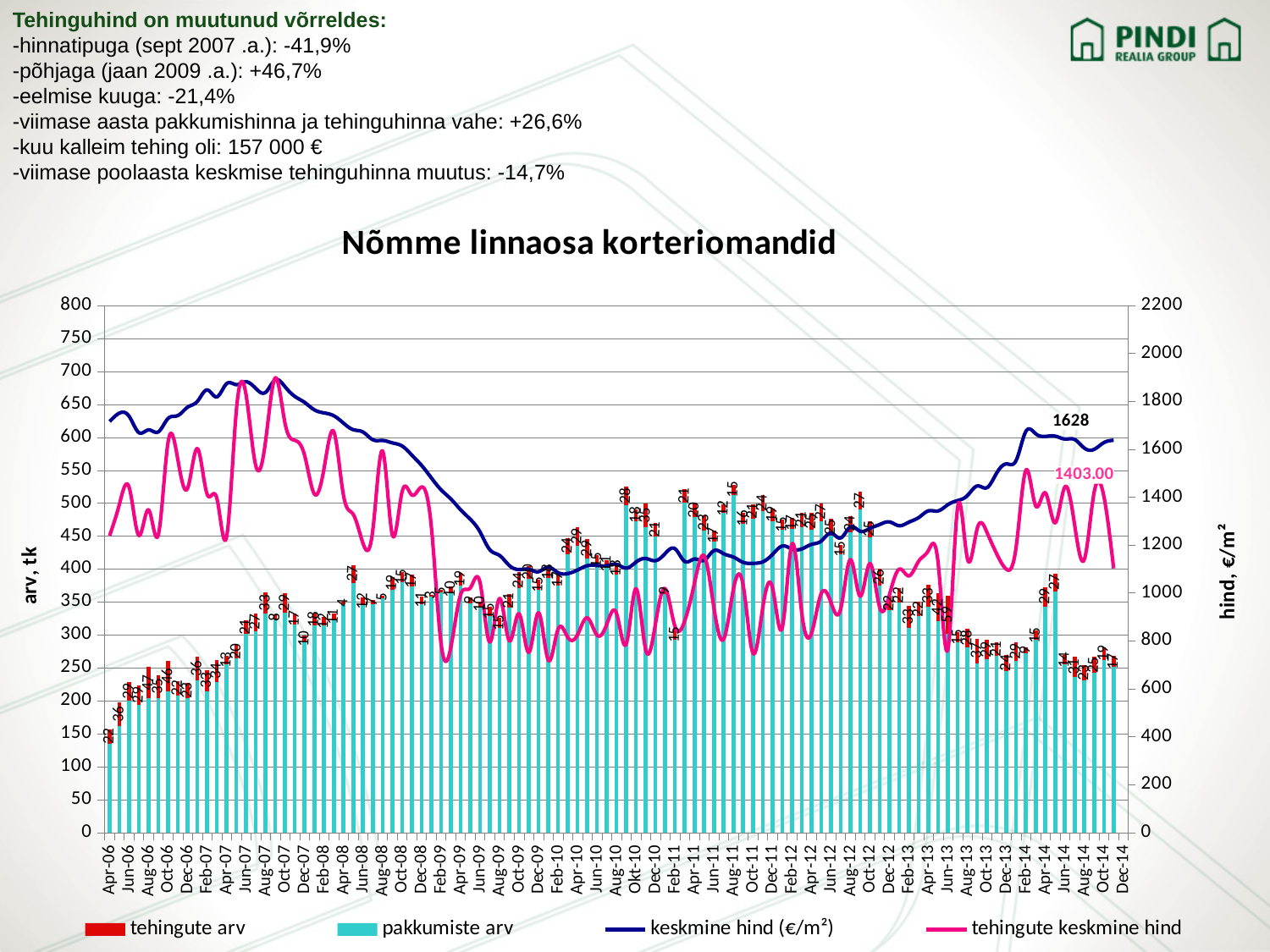
What is the title of the chart? Nõmme linnaosa korteriomandid Is the pakkumiste arv bar for Apr-06 greater or less than 200? less What is the labelled value of the tehingute keskmine hind line at the end of the chart (Dec-14)? 1403.00 What is the labelled value of the keskmine hind (€/m²) line at the end of the chart (Dec-14)? 1628 Is the peak of the keskmine hind (€/m²) line in 2007 greater or less than 1800? greater What is the difference between the labelled end values of keskmine hind (1628) and tehingute keskmine hind (1403.00)? 225 Does the keskmine hind (€/m²) line rise or fall between Oct-07 and Oct-09? fall How many series does the legend list? 4 What colour is the keskmine hind (€/m²) line? Dark blue Is the pakkumiste arv bar for Oct-10 greater or less than 400? greater What kind of chart is shown on the slide? A combined bar and line chart At Dec-14, which is larger: keskmine hind (€/m²) or tehingute keskmine hind? keskmine hind (€/m²)